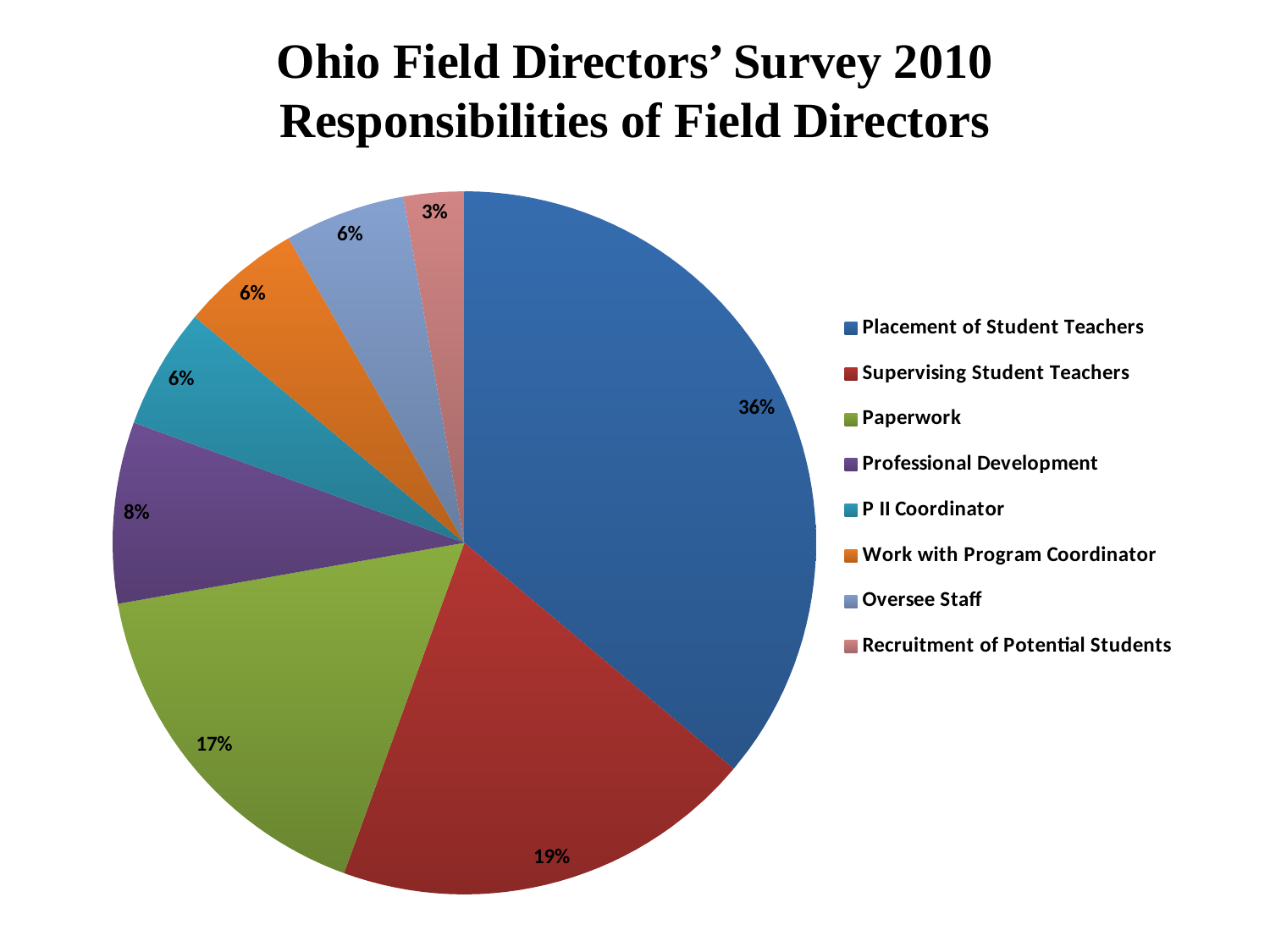
What is the title of the chart? Ohio Field Directors' Survey 2010 Responsibilities of Field Directors Which responsibility has the largest slice of the pie? Placement of Student Teachers What share of the pie is Professional Development? 8% Which is larger, the slice for Paperwork or the slice for Professional Development? Paperwork What share of the pie is Paperwork? 17% What is the difference in percentage points between Placement of Student Teachers and Supervising Student Teachers? 17 What share of the pie is Placement of Student Teachers? 36% How many categories does the legend list? 8 Which responsibility has the smallest slice of the pie? Recruitment of Potential Students What kind of chart is shown on the slide? pie chart